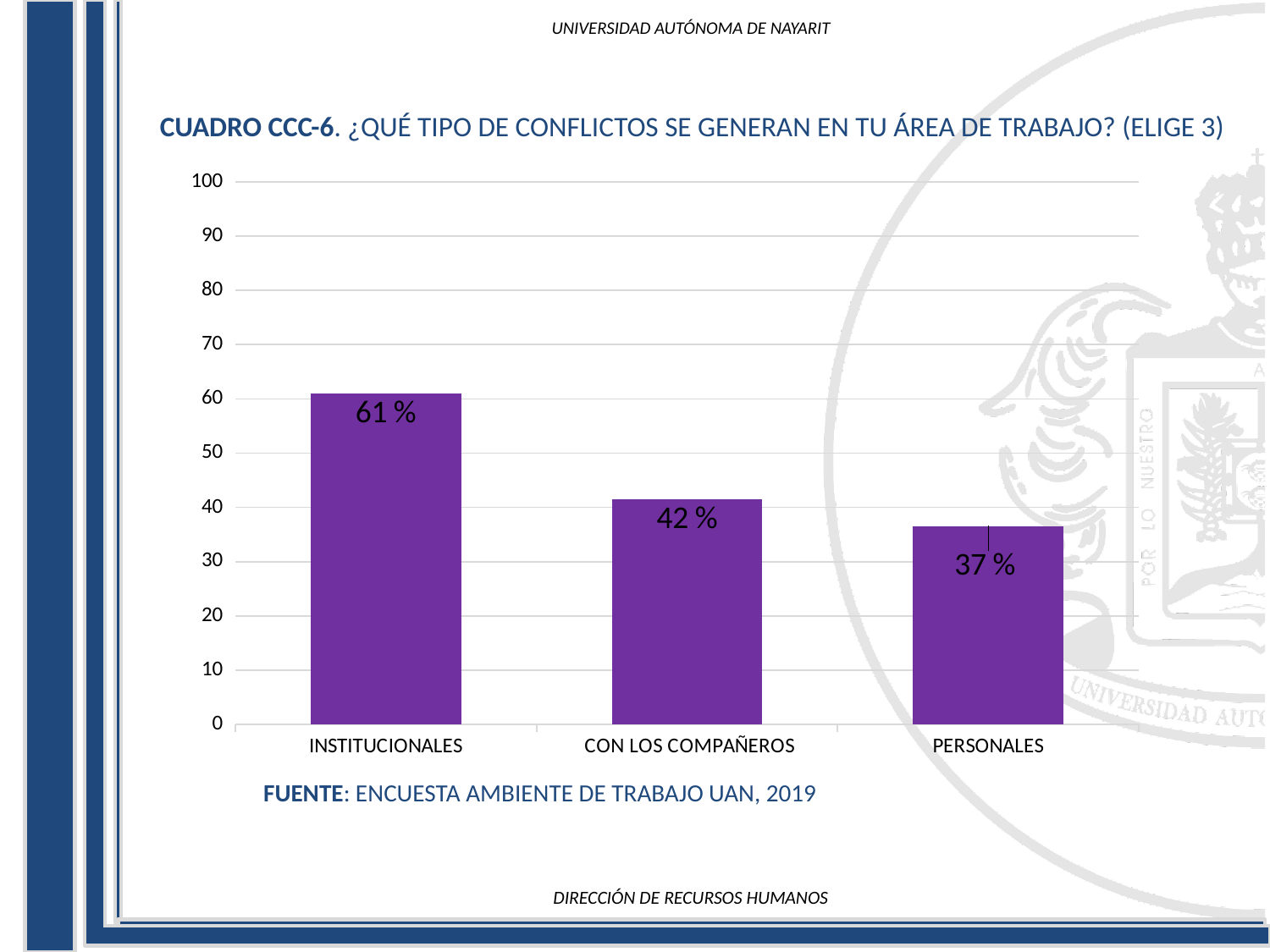
What is the difference between the values for INSTITUCIONALES and PERSONALES? 24 % What kind of chart is shown on the slide? bar chart What source is cited below the chart? ENCUESTA AMBIENTE DE TRABAJO UAN, 2019 Which category has the lowest value? PERSONALES Which category has the highest value? INSTITUCIONALES What is the difference between the values for CON LOS COMPAÑEROS and PERSONALES? 5 % Which is larger, the value for INSTITUCIONALES or the value for CON LOS COMPAÑEROS? INSTITUCIONALES What is the value for INSTITUCIONALES? 61 % What is the value for CON LOS COMPAÑEROS? 42 % How many categories are shown on the x axis? 3 Is the value for CON LOS COMPAÑEROS greater or less than 50? less What is the value for PERSONALES? 37 %